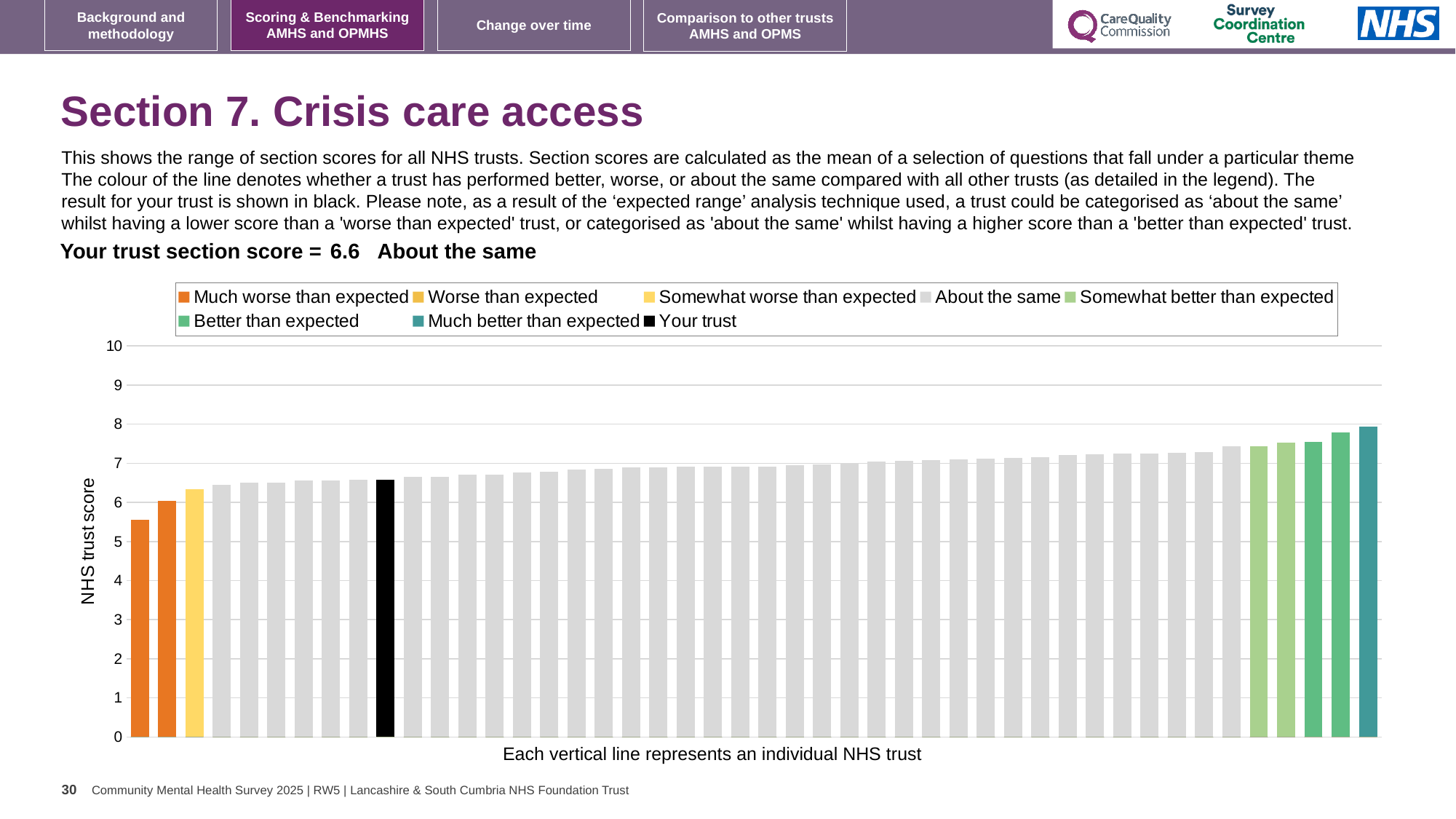
What is the section score for your trust shown on the slide? 6.6 What kind of chart is shown on the slide? bar chart What is the label on the vertical axis of the chart? NHS trust score How is your trust's section score categorised compared with other trusts? About the same Is the value of the rightmost (highest) bar greater or less than 7? greater How many bars are coloured orange (Much worse than expected)? 2 Is the value of the leftmost (lowest) bar greater or less than 6? less How many entries does the chart legend list? 8 Is the value of the black 'Your trust' bar greater or less than 5? greater What colour is the bar representing your trust? black Do the bar values rise or fall from left to right across the chart? rise Which is higher, the leftmost bar or the rightmost bar? the rightmost bar